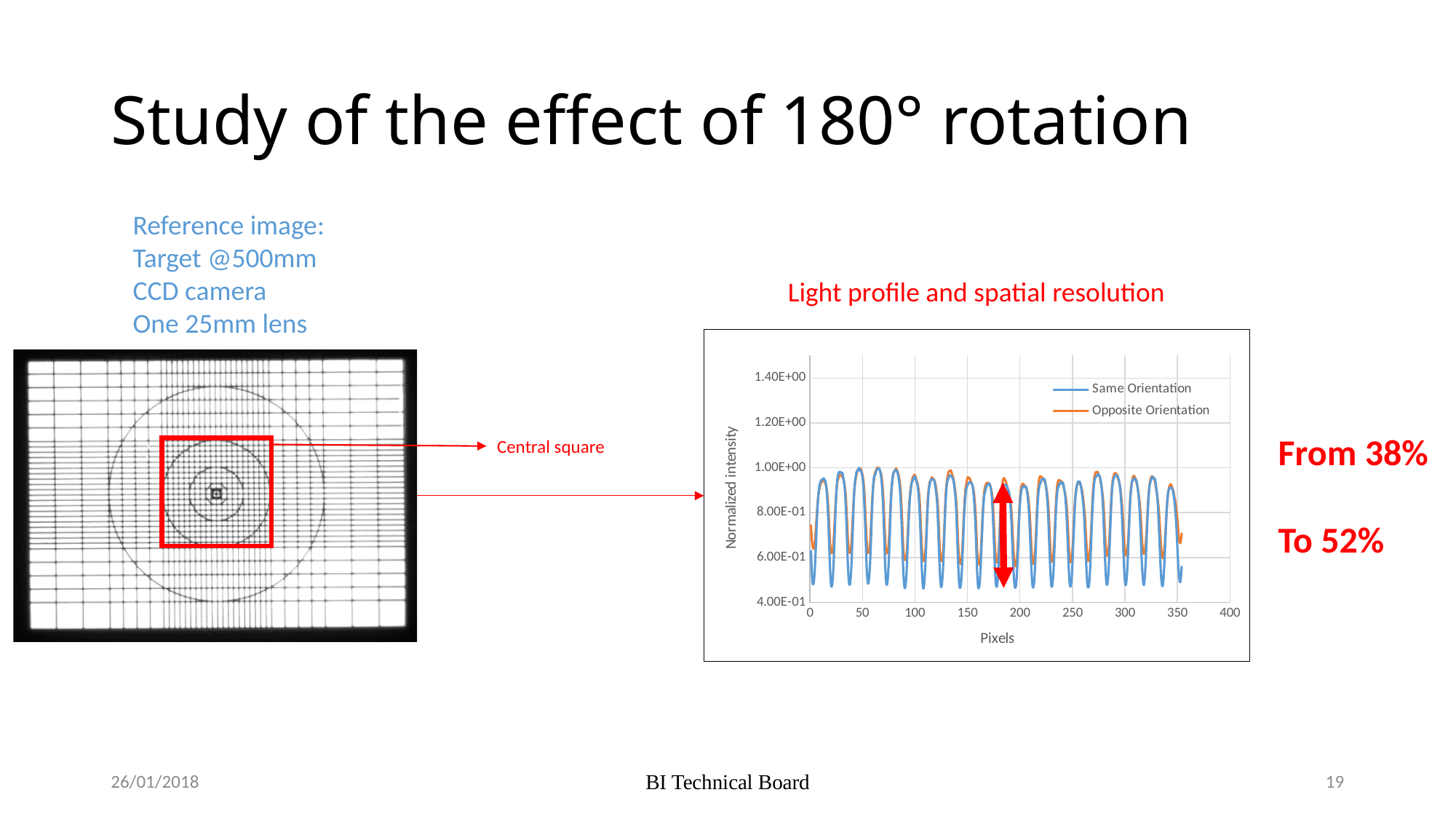
Are the lowest values of the Same Orientation series greater or less than 4.00E-01? greater Are the peak values of the Same Orientation series greater or less than 1.20E+00? less Are the trough values of the Opposite Orientation series greater or less than 8.00E-01? less What is the label of the chart's x axis? Pixels Which series reaches lower trough values, Same Orientation or Opposite Orientation? Same Orientation What kind of chart is shown on the slide? line chart What are the two series named in the chart's legend? Same Orientation and Opposite Orientation How many series does the chart's legend list? 2